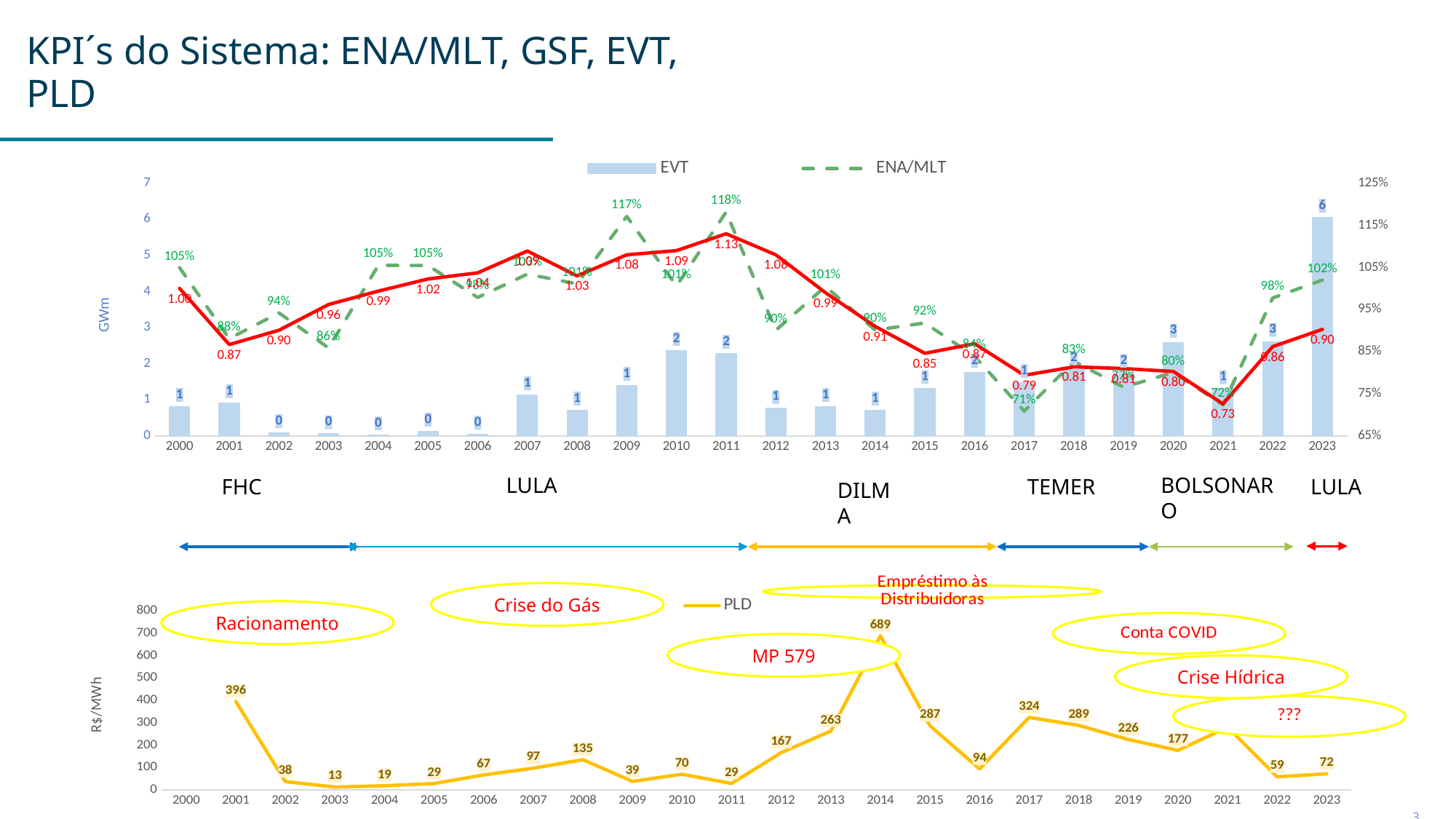
In the top chart, which year has the lowest ENA/MLT value? 2017 In the top chart, what is the EVT value for 2023? 6 In the bottom chart, which year has the highest PLD value? 2014 In the bottom chart, what is the PLD value for 2001? 396 In the bottom chart, what is the difference between the PLD values for 2014 and 2015? 402 What kind of chart is the bottom chart? line chart In the bottom chart, which year has the larger PLD value, 2017 or 2018? 2017 In the top chart, how many series does the legend list? 2 In the top chart, what is the ENA/MLT value for 2011? 118% In the bottom chart, what is the PLD value for 2014? 689 In the bottom chart, which year has the lowest PLD value? 2003 In the bottom chart, does the PLD value rise or fall from 2001 to 2003? fall